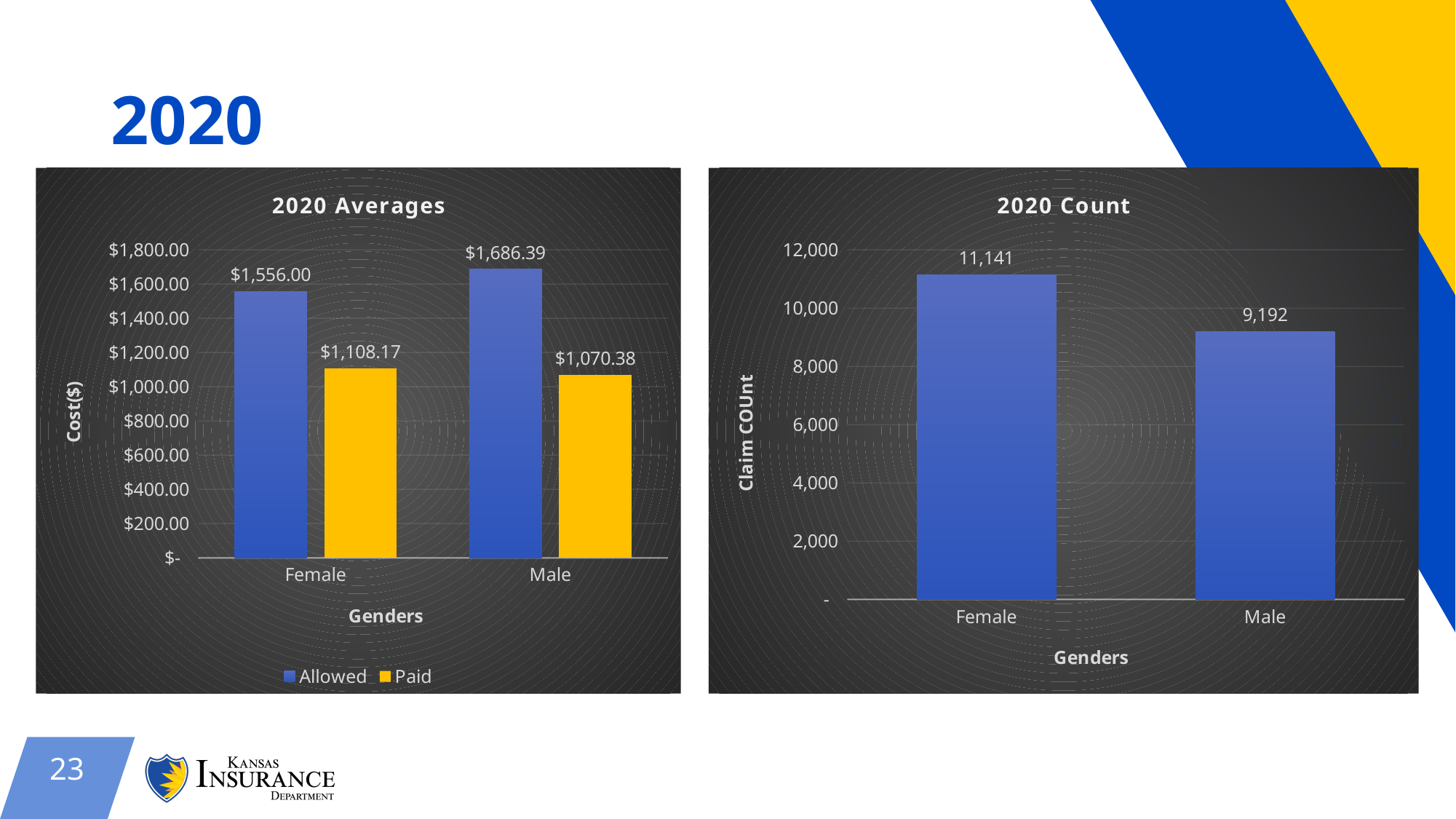
In the '2020 Averages' chart, what is the Paid value for Female? $1,108.17 What kind of chart is the '2020 Count' chart? Bar chart In the '2020 Averages' chart, which gender has the higher Allowed value? Male In the '2020 Averages' chart, what is the Paid value for Male? $1,070.38 In the '2020 Averages' chart, what is the Allowed value for Female? $1,556.00 In the '2020 Count' chart, which gender has the lowest claim count? Male In the '2020 Averages' chart, which series is shown in yellow? Paid In the '2020 Count' chart, what is the claim count for Male? 9,192 In the '2020 Averages' chart, how many series does the legend list? 2 In the '2020 Count' chart, what is the claim count for Female? 11,141 In the '2020 Averages' chart, what is the difference between the Allowed and Paid values for Male? $616.01 In the '2020 Count' chart, what is the difference between the Female and Male claim counts? 1,949